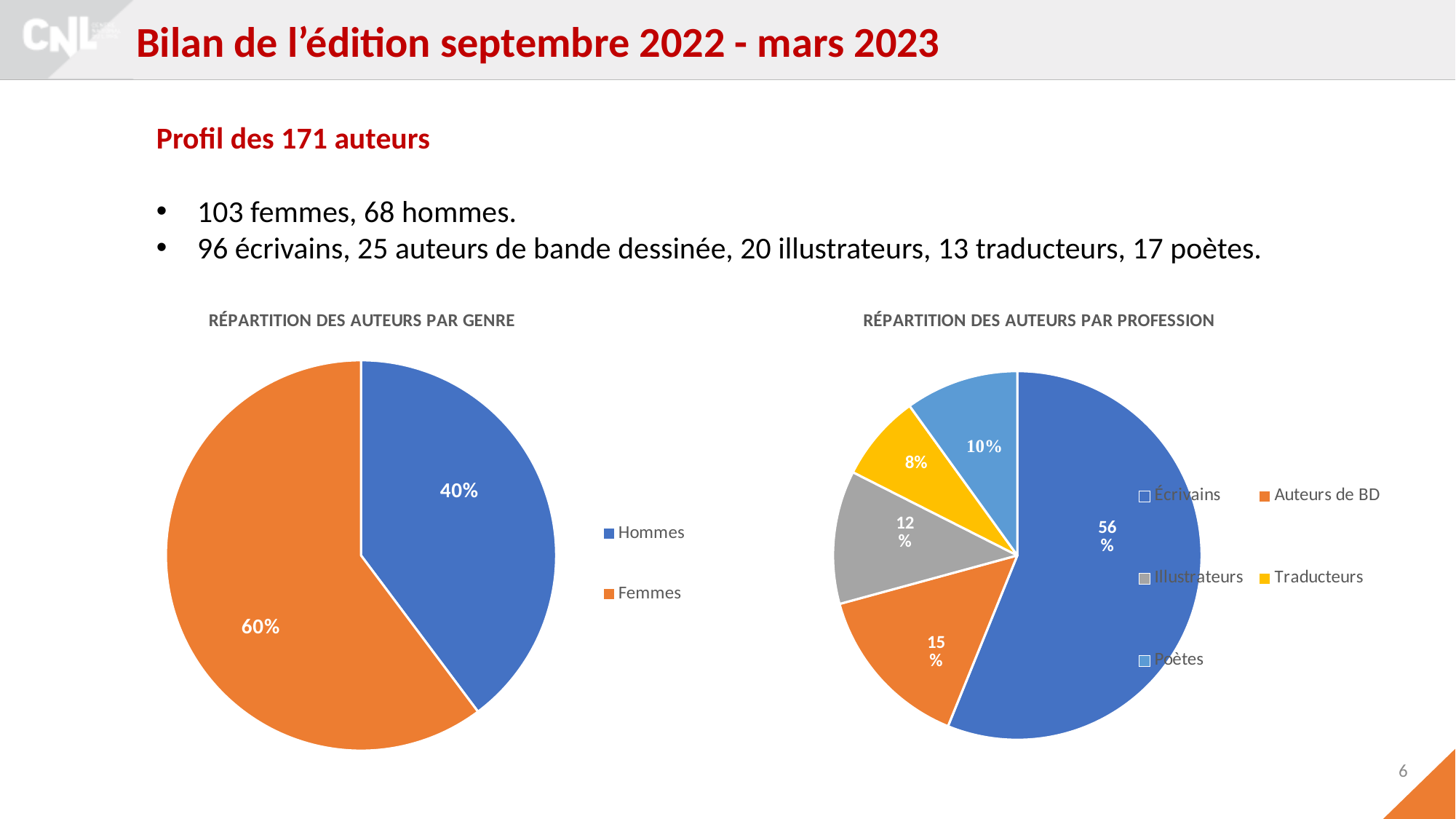
What kind of chart is the one titled 'RÉPARTITION DES AUTEURS PAR PROFESSION'? Pie chart In the chart titled 'RÉPARTITION DES AUTEURS PAR PROFESSION', which profession has the largest share? Écrivains In the chart titled 'RÉPARTITION DES AUTEURS PAR PROFESSION', what share of the pie is Écrivains? 56% In the chart titled 'RÉPARTITION DES AUTEURS PAR GENRE', what share of the pie is Femmes? 60% In the chart titled 'RÉPARTITION DES AUTEURS PAR PROFESSION', which profession has the smallest share? Traducteurs In the chart titled 'RÉPARTITION DES AUTEURS PAR PROFESSION', what is the difference in percentage points between Illustrateurs and Poètes? 2 percentage points In the chart titled 'RÉPARTITION DES AUTEURS PAR GENRE', which category has the larger share, Hommes or Femmes? Femmes In the chart titled 'RÉPARTITION DES AUTEURS PAR PROFESSION', what share of the pie is Traducteurs? 8% In the chart titled 'RÉPARTITION DES AUTEURS PAR GENRE', what is the difference in percentage points between Femmes and Hommes? 20 percentage points How many categories does the legend of the chart titled 'RÉPARTITION DES AUTEURS PAR PROFESSION' list? 5